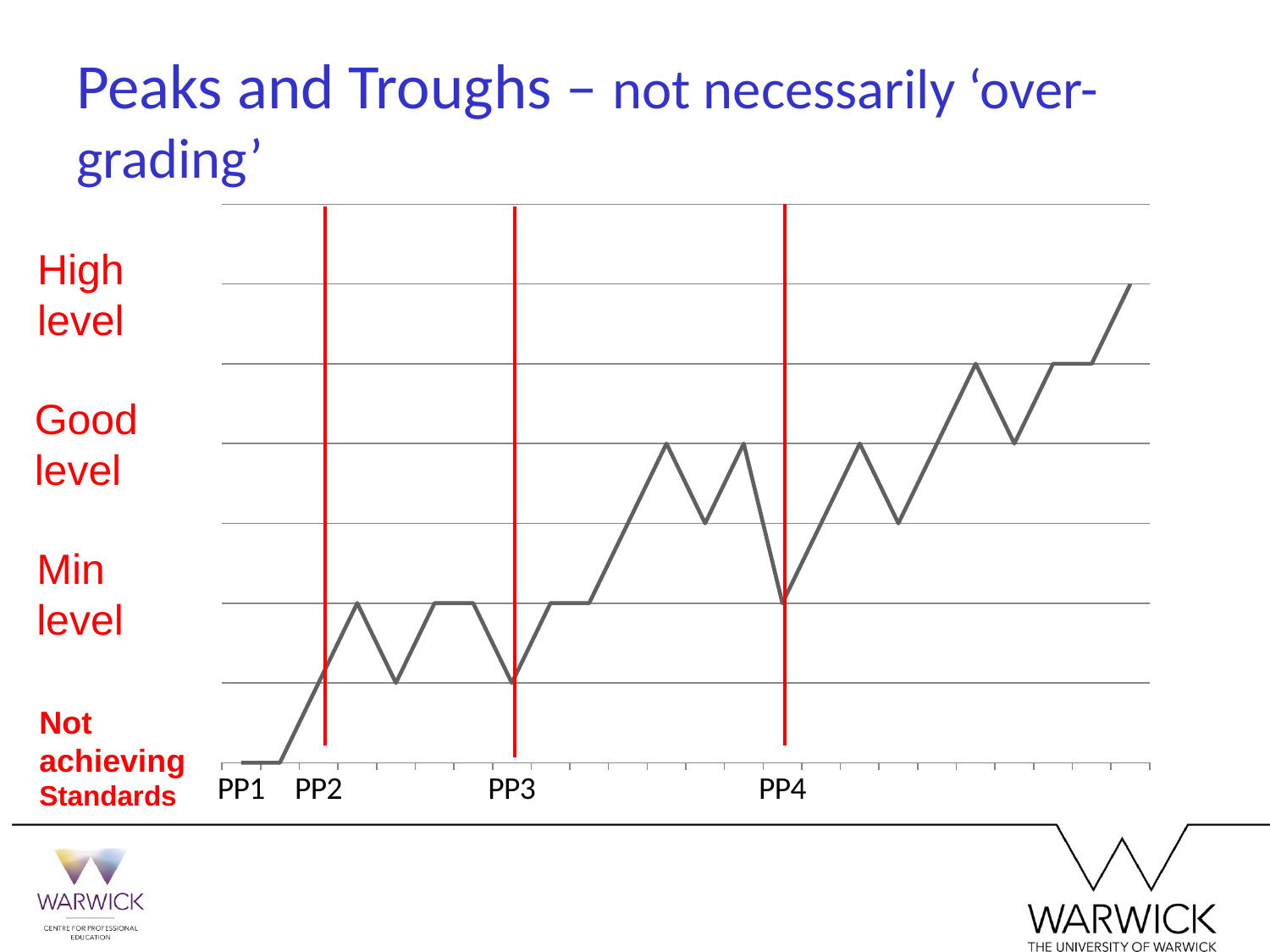
Which level label does the line sit on at PP4? Min level What kind of chart is shown on the slide? line chart What is the title of the slide containing the chart? Peaks and Troughs – not necessarily 'over-grading' How many labelled points (PP1 to PP4) are marked along the x axis? 4 Overall, does the plotted line rise or fall from left to right? rise What colour are the vertical lines marking PP2, PP3 and PP4? red How many red vertical lines are drawn on the chart? 3 Which level label does the line reach at its final point on the far right? High level At which labelled x-axis point is the line at its lowest? PP1 Between PP1 and PP2, is the line above or below the Min level gridline? below Between PP3 and PP4, does the line reach the Good level gridline? yes Is the line higher at PP4 or at PP1? PP4